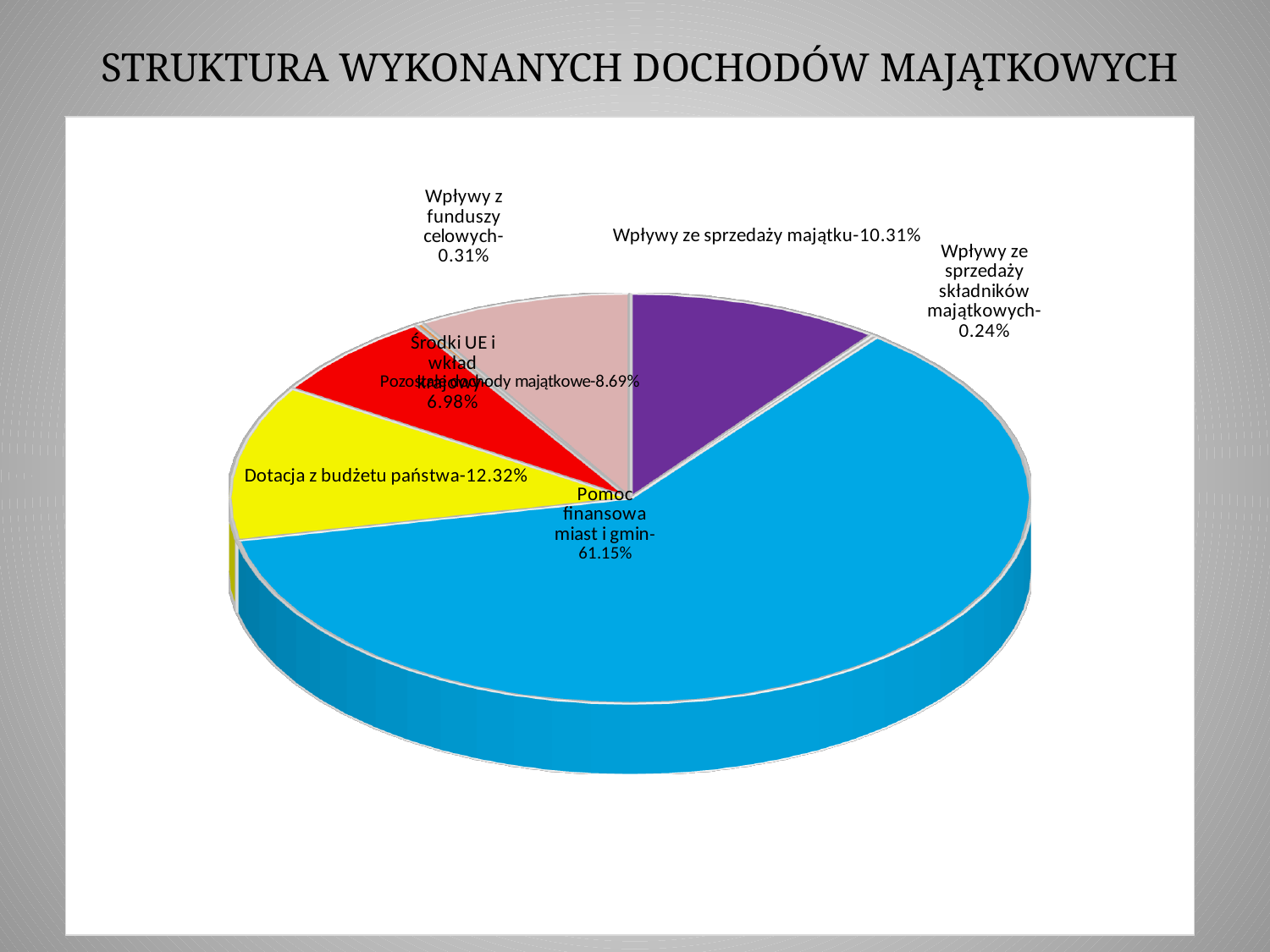
What share of the pie is 'Pomoc finansowa miast i gmin'? 61.15% What share of the pie is 'Dotacja z budżetu państwa'? 12.32% What kind of chart is shown on the slide? pie chart Which category has the smallest share of the pie? Wpływy ze sprzedaży składników majątkowych What is the difference between the shares of 'Dotacja z budżetu państwa' and 'Wpływy ze sprzedaży majątku'? 2.01% What share of the pie is 'Wpływy ze sprzedaży majątku'? 10.31% Which is larger: 'Dotacja z budżetu państwa' or 'Wpływy ze sprzedaży majątku'? Dotacja z budżetu państwa What is the title of the slide? STRUKTURA WYKONANYCH DOCHODÓW MAJĄTKOWYCH Which category has the largest share of the pie? Pomoc finansowa miast i gmin